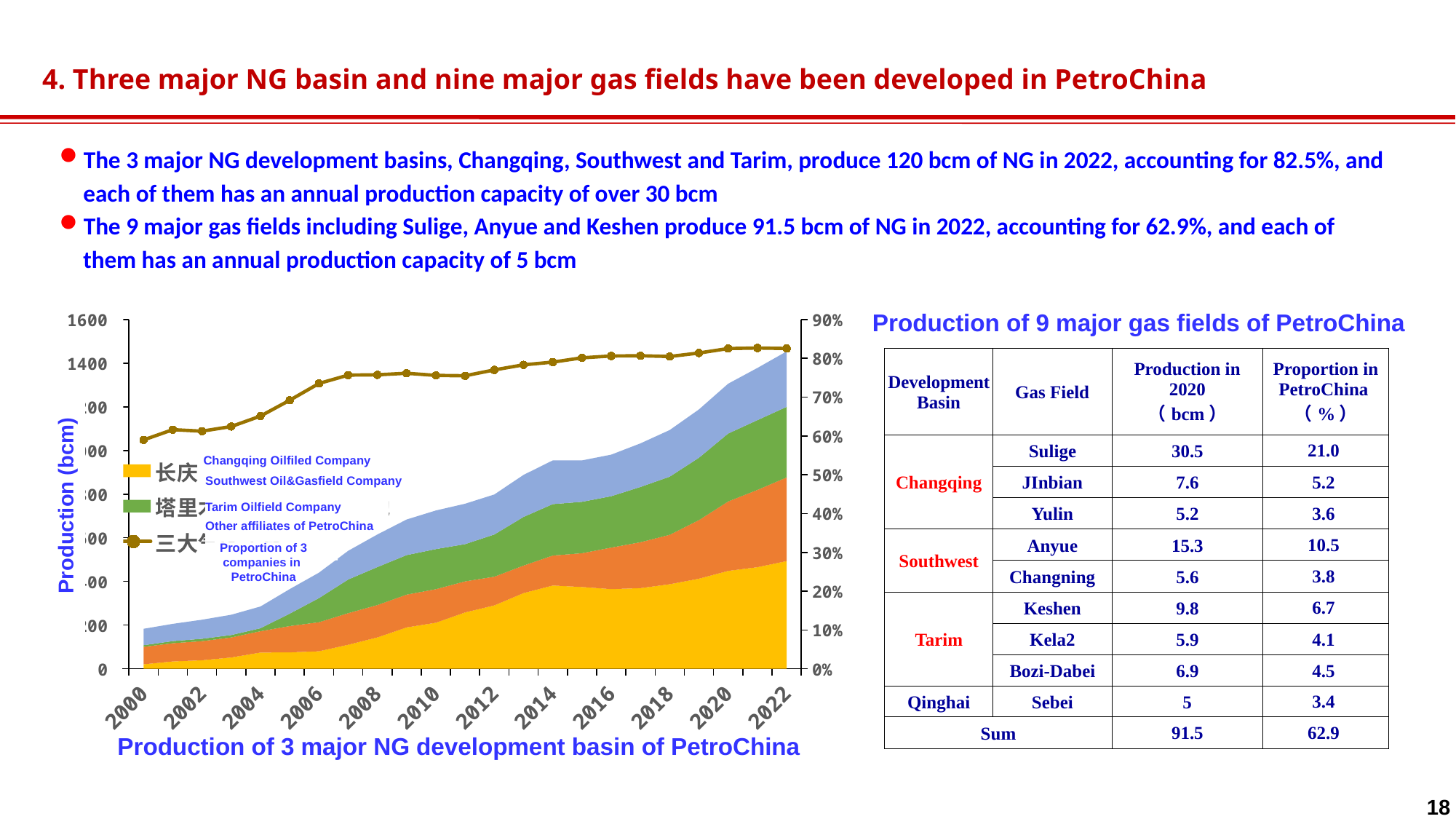
Does the proportion of the 3 companies in PetroChina rise or fall overall from 2000 to 2022? Rise Which is larger, the proportion of the 3 companies in PetroChina in 2022 or in 2000? 2022 Is the proportion of the 3 companies in PetroChina in 2000 greater or less than 50%? greater How many year labels are shown along the x axis of the chart? 12 What kind of chart is used to show the production of the 3 major NG development basins? Stacked area chart with a line Which year has the lowest proportion of the 3 companies in PetroChina? 2000 Is the proportion of the 3 companies in PetroChina in 2010 greater or less than 70%? greater Is the proportion of the 3 companies in PetroChina in 2022 greater or less than 80%? greater Does the total stacked production rise or fall overall from 2000 to 2022? Rise What is the label of the left vertical axis of the chart? Production (bcm) What is the title of the chart on the slide? Production of 3 major NG development basin of PetroChina